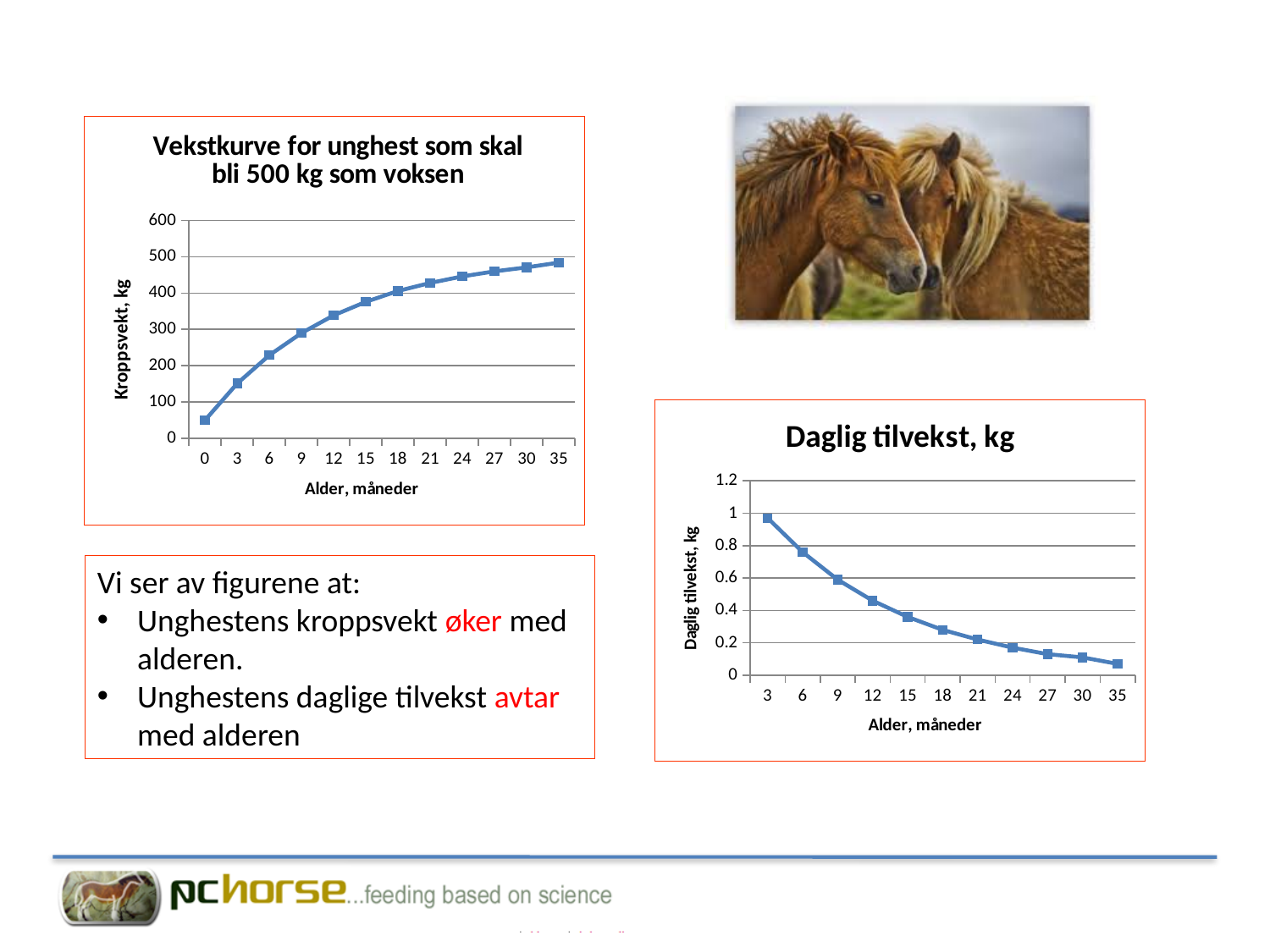
In the 'Vekstkurve for unghest som skal bli 500 kg som voksen' chart, at which age in months is the body weight highest? 35 In the 'Daglig tilvekst, kg' chart, at which age in months is the daily gain lowest? 35 How many data points are plotted in the 'Vekstkurve for unghest som skal bli 500 kg som voksen' chart? 12 What is the y-axis title of the 'Vekstkurve for unghest som skal bli 500 kg som voksen' chart? Kroppsvekt, kg What kind of chart is the 'Vekstkurve for unghest som skal bli 500 kg som voksen' chart? Line chart In the 'Vekstkurve for unghest som skal bli 500 kg som voksen' chart, do the values rise or fall as age increases along the x axis? Rise In the 'Daglig tilvekst, kg' chart, do the values rise or fall as age increases along the x axis? Fall In the 'Daglig tilvekst, kg' chart, is the value at 3 months greater or less than 0.8? greater In the 'Daglig tilvekst, kg' chart, is the value at 18 months greater or less than 0.4? less In the 'Vekstkurve for unghest som skal bli 500 kg som voksen' chart, is the body weight at 12 months greater or less than 300? greater How many data points are plotted in the 'Daglig tilvekst, kg' chart? 11 In the 'Vekstkurve for unghest som skal bli 500 kg som voksen' chart, which is larger: the body weight at 6 months or at 9 months? 9 months